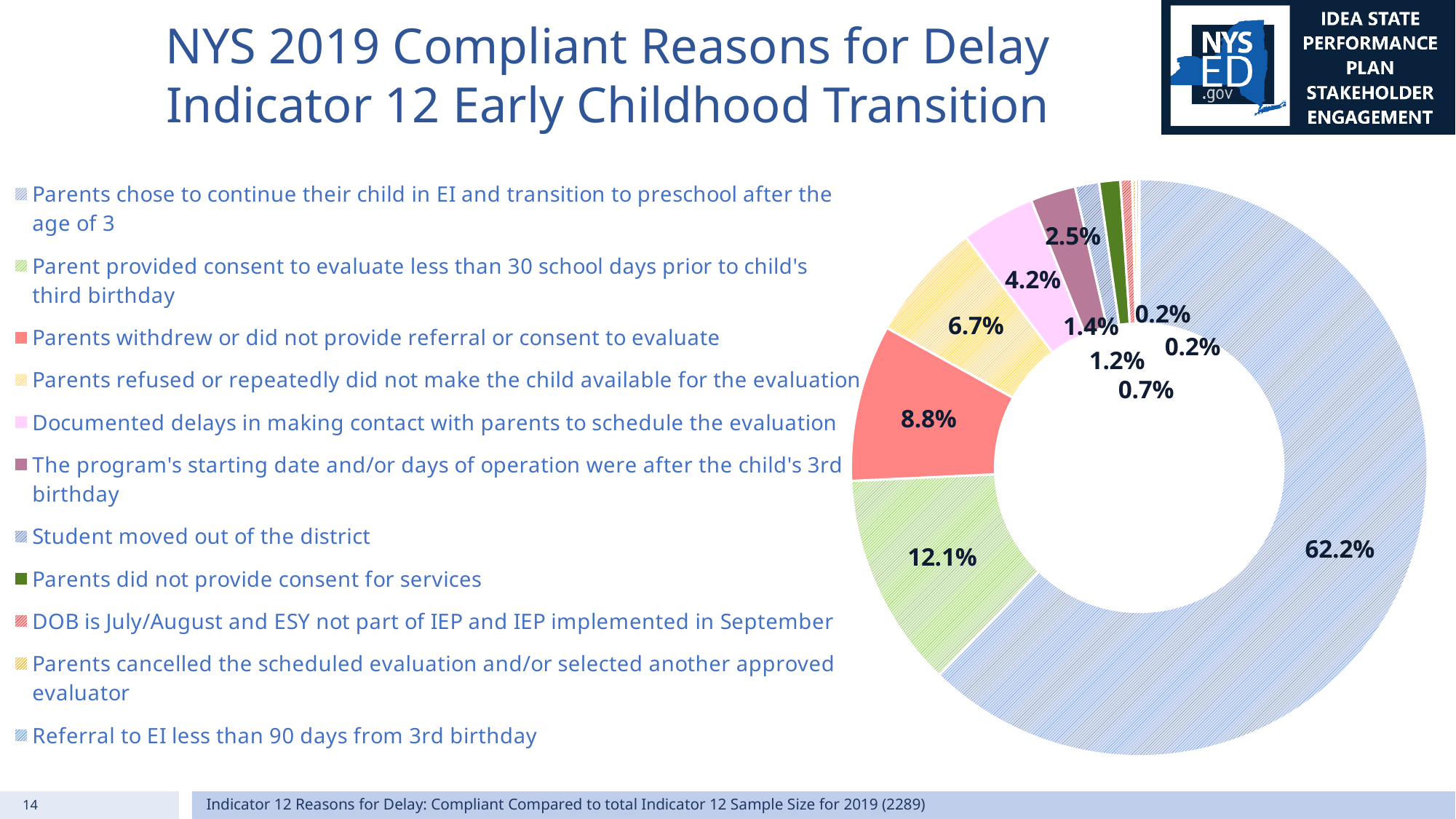
What is the difference in percentage points between the largest slice (62.2%) and the 'Parent provided consent to evaluate less than 30 school days prior to child's third birthday' slice (12.1%)? 50.1 percentage points How many reasons for delay are listed in the chart legend? 11 What is the title of the slide containing the chart? NYS 2019 Compliant Reasons for Delay Indicator 12 Early Childhood Transition What percentage is shown for 'The program's starting date and/or days of operation were after the child's 3rd birthday'? 2.5% What share of the chart is for 'Parents chose to continue their child in EI and transition to preschool after the age of 3'? 62.2% What percentage is shown for 'Parents withdrew or did not provide referral or consent to evaluate'? 8.8% What kind of chart is shown on the slide? Pie (doughnut) chart What percentage is shown for 'Parents refused or repeatedly did not make the child available for the evaluation'? 6.7% What percentage is shown for 'Documented delays in making contact with parents to schedule the evaluation'? 4.2% What percentage is shown for 'Parent provided consent to evaluate less than 30 school days prior to child's third birthday'? 12.1% Which is larger: the share for 'Parents withdrew or did not provide referral or consent to evaluate' or the share for 'Parents refused or repeatedly did not make the child available for the evaluation'? Parents withdrew or did not provide referral or consent to evaluate Which reason for delay has the largest share of the chart? Parents chose to continue their child in EI and transition to preschool after the age of 3